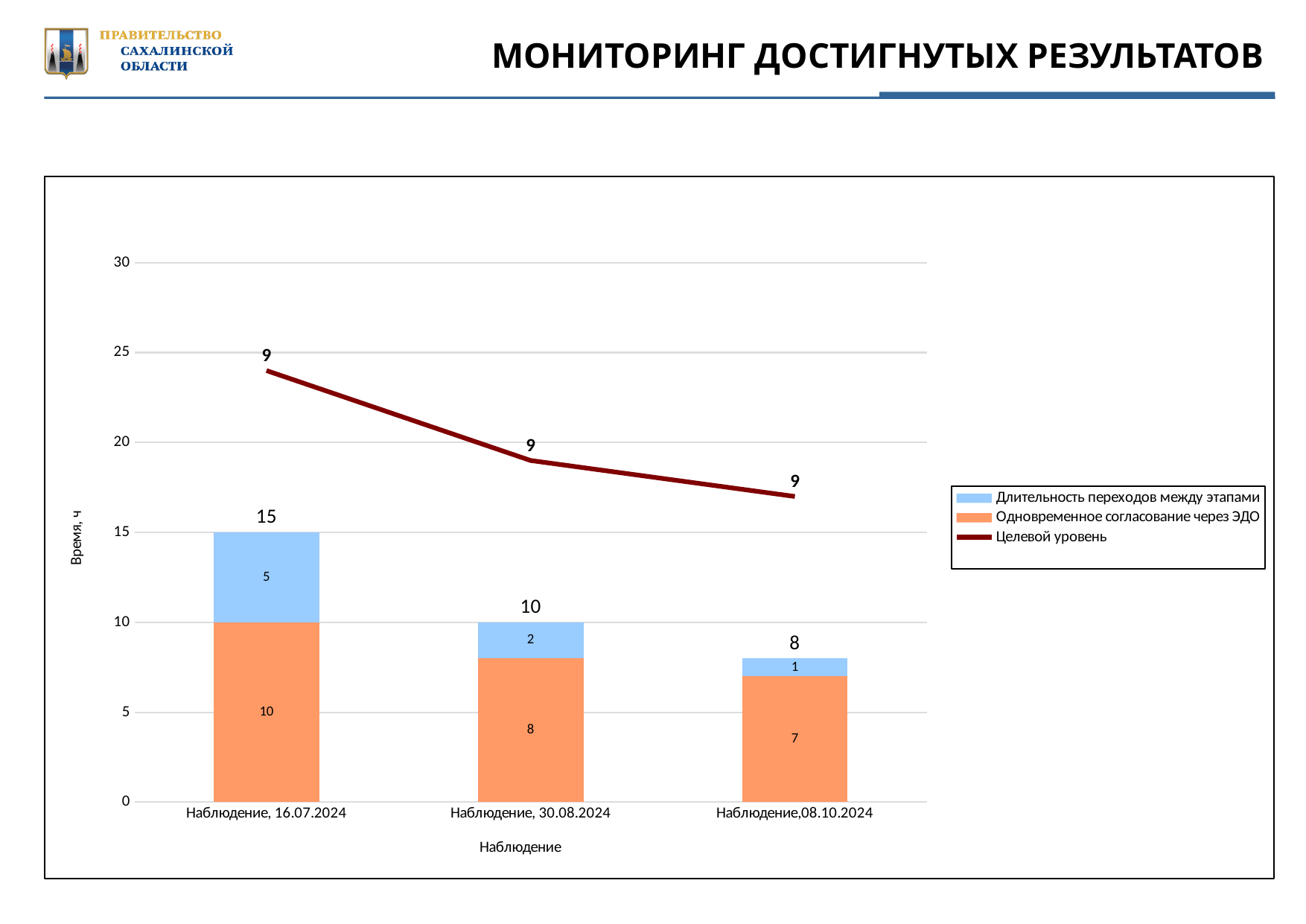
Which is larger: Одновременное согласование через ЭДО for Наблюдение, 16.07.2024 or for Наблюдение,08.10.2024? Наблюдение, 16.07.2024 What is the value of Длительность переходов между этапами for Наблюдение, 16.07.2024? 5 How many series does the legend list? 3 Which observation has the highest total bar value? Наблюдение, 16.07.2024 How many observation categories are shown on the x axis? 3 What is the total value of the stacked bar for Наблюдение, 16.07.2024? 15 Which observation has the lowest total bar value? Наблюдение,08.10.2024 Do the total bar values rise or fall from the first observation to the last? fall What is the total value of the stacked bar for Наблюдение,08.10.2024? 8 What is the difference between the total bar values for Наблюдение, 16.07.2024 and Наблюдение, 30.08.2024? 5 What is the value of Одновременное согласование через ЭДО for Наблюдение, 30.08.2024? 8 What is the value of Длительность переходов между этапами for Наблюдение,08.10.2024? 1